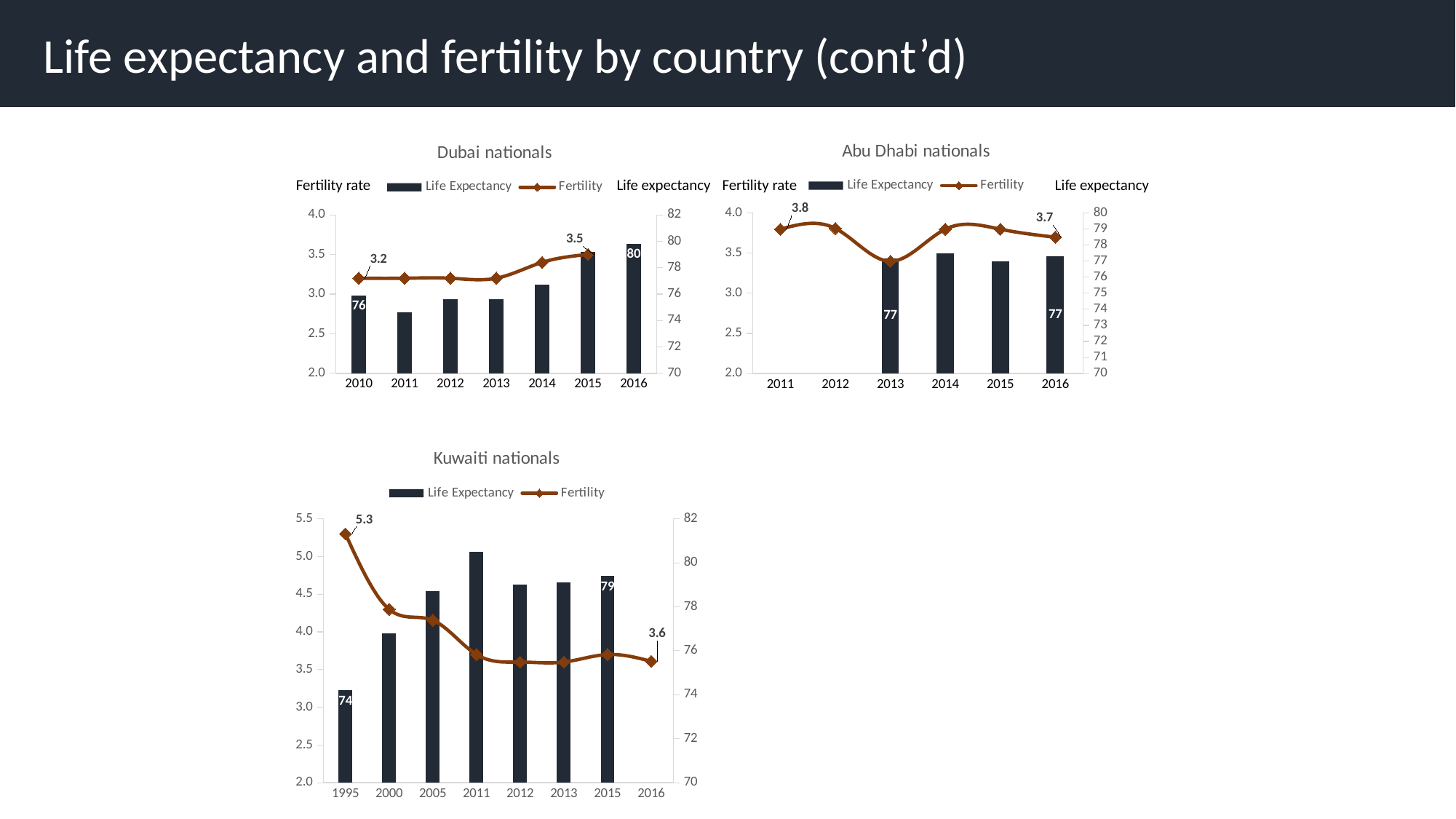
In the Dubai nationals chart, by how much did life expectancy increase from 2010 to 2016? 4 In the Abu Dhabi nationals chart, what is the life expectancy for 2013? 77 In the Kuwaiti nationals chart, does the fertility rate generally rise or fall from 1995 to 2016? fall In the Dubai nationals chart, what is the fertility rate for 2010? 3.2 In the Dubai nationals chart, what is the life expectancy for 2016? 80 In the Abu Dhabi nationals chart, what is the fertility rate for 2011? 3.8 In the Dubai nationals chart, which year has the lowest life expectancy bar? 2011 In the Kuwaiti nationals chart, what is the difference between the fertility rate in 1995 and in 2016? 1.7 How many series does the legend of the Abu Dhabi nationals chart list? 2 In the Kuwaiti nationals chart, which year has the lowest life expectancy bar? 1995 How many years are shown on the x axis of the Dubai nationals chart? 7 In the Kuwaiti nationals chart, what is the fertility rate for 1995? 5.3